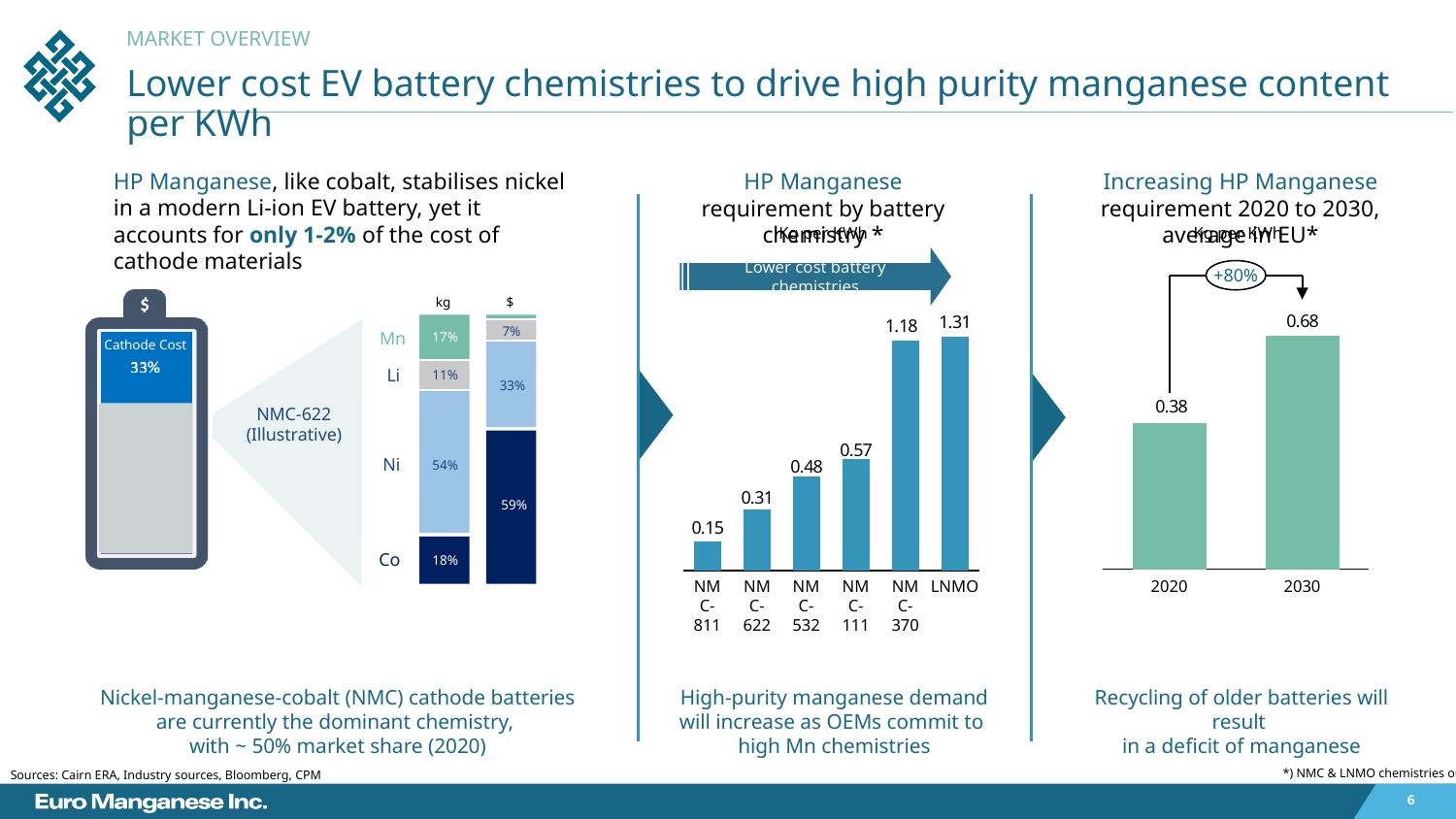
In the 'HP Manganese requirement by battery chemistry' chart, do the values rise or fall from left to right? rise In the 'HP Manganese requirement by battery chemistry' chart, what is the difference between NMC-111 and NMC-532? 0.09 In the 'Increasing HP Manganese requirement 2020 to 2030' chart, what is the value for 2030? 0.68 In the 'Increasing HP Manganese requirement 2020 to 2030' chart, what is the difference between 2030 and 2020? 0.30 In the 'HP Manganese requirement by battery chemistry' chart, what is the value for LNMO? 1.31 In the 'HP Manganese requirement by battery chemistry' chart, how many chemistries are shown? 6 In the NMC-622 stacked bar chart on the left, what share of the kg bar is Ni? 54% In the 'HP Manganese requirement by battery chemistry' chart, what is the value for NMC-370? 1.18 In the 'HP Manganese requirement by battery chemistry' chart, which chemistry has the lowest value? NMC-811 In the 'Increasing HP Manganese requirement 2020 to 2030' chart, what is the value for 2020? 0.38 In the 'HP Manganese requirement by battery chemistry' chart, what is the value for NMC-811? 0.15 In the 'HP Manganese requirement by battery chemistry' chart, which chemistry has the highest value? LNMO